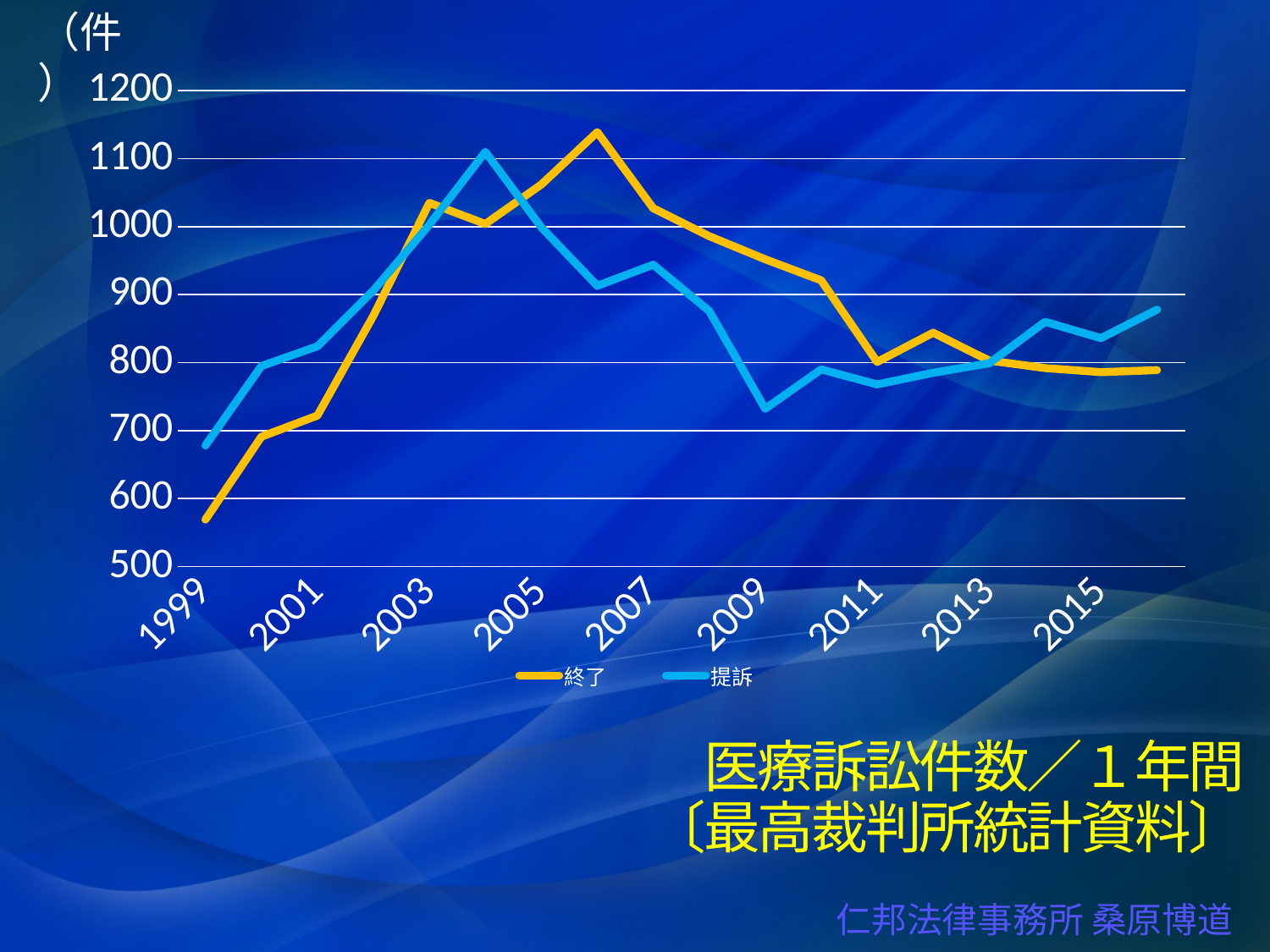
Is the value for 提訴 in 1999 greater or less than 600? greater What are the two series named in the legend? 終了 and 提訴 In 1999, which series has the higher value, 終了 or 提訴? 提訴 Is the value for 終了 in 1999 greater or less than 600? less In 2007, which series has the higher value, 終了 or 提訴? 終了 What kind of chart is shown on the slide? line chart What is the title of the chart? 医療訴訟件数／１年間〔最高裁判所統計資料〕 Is the value for 終了 in 2003 greater or less than 900? greater How many series does the legend list? 2 Does the 終了 line rise or fall between 2007 and 2011? fall